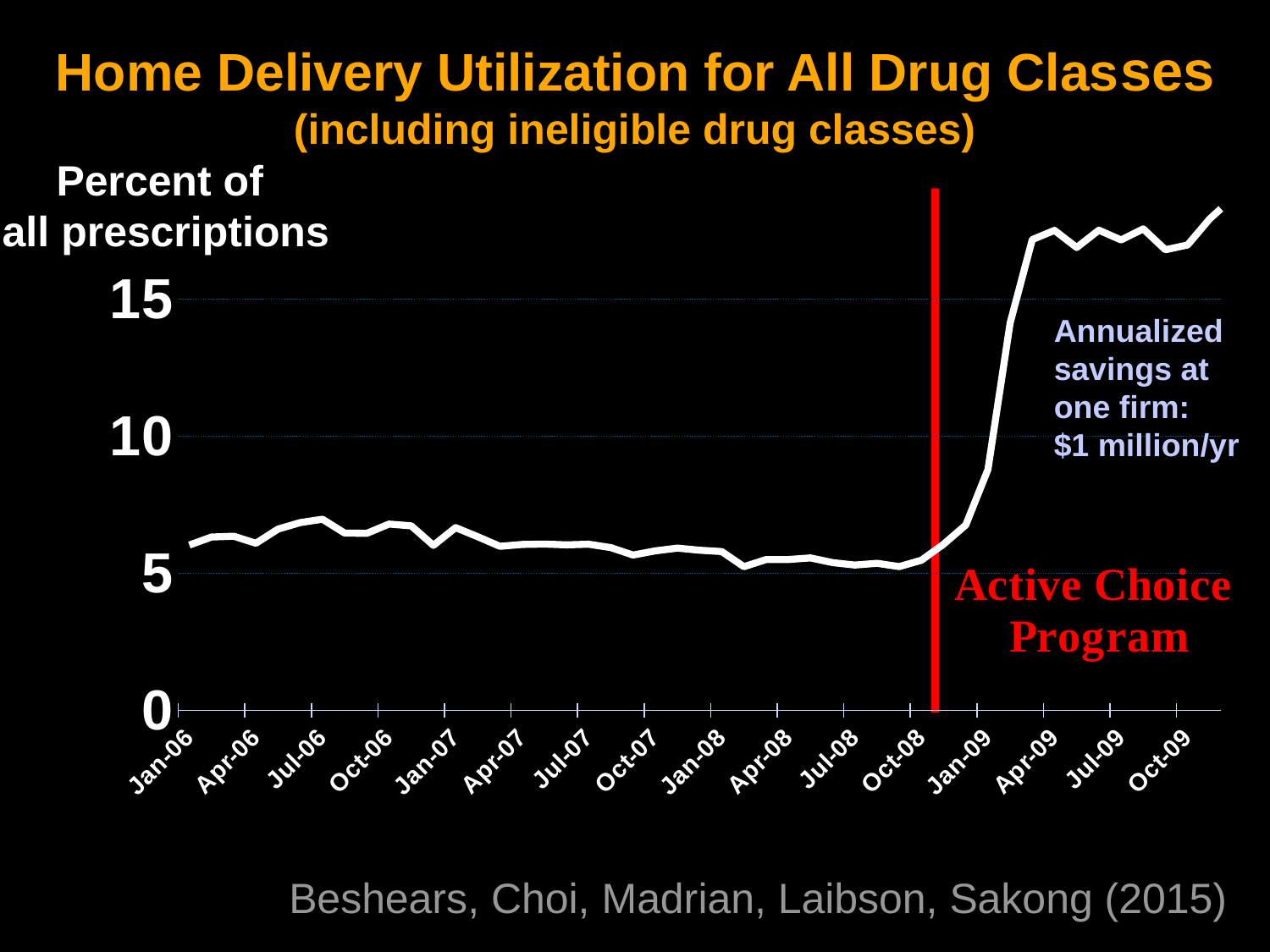
How many labeled tick marks are on the x axis? 16 Which is larger, the value for Jul-06 or the value for Oct-08? Jul-06 Is the value for Oct-08 greater or less than 10? less Is the value for Oct-09 greater or less than 15? greater What is the y-axis label of the chart? Percent of all prescriptions What label is written next to the red vertical line? Active Choice Program Is the value for Apr-09 greater or less than 15? greater Which is larger, the value for Apr-09 or the value for Jan-06? Apr-09 Does the line rise or fall sharply just after the red vertical line? rise What kind of chart is shown on the slide? line chart